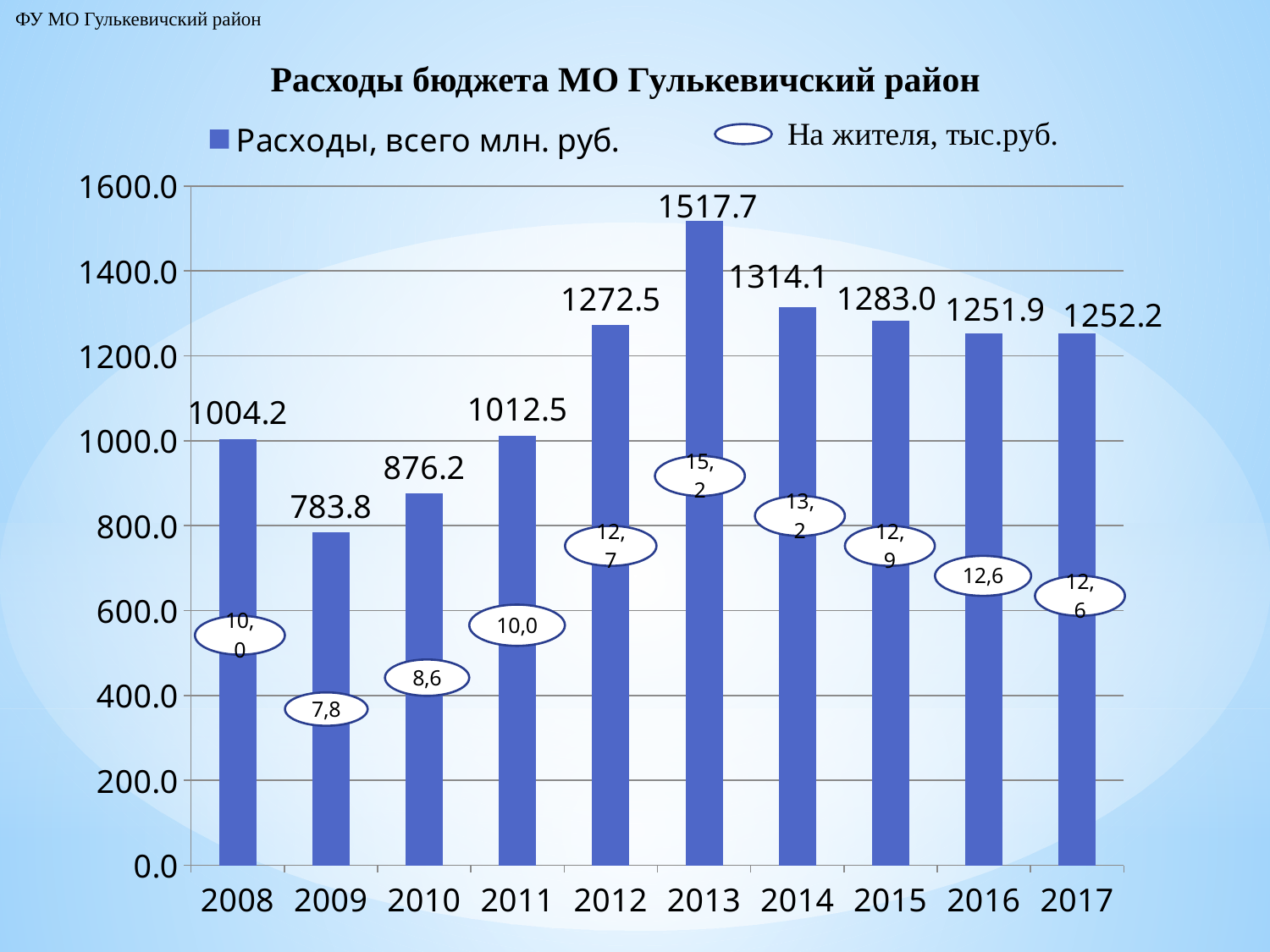
What is the title of the chart? Расходы бюджета МО Гулькевичский район Which year has the highest total budget expenditure? 2013 How many series does the legend list? 2 What type of chart is shown on the slide? bar chart Which year had higher total expenditure, 2011 or 2012? 2012 What was the total budget expenditure (Расходы, всего млн. руб.) in 2013? 1517.7 Is the total expenditure for 2010 greater or less than 1000.0? less How many years are shown on the x axis? 10 Which year has the lowest total budget expenditure? 2009 What was the total budget expenditure (Расходы, всего млн. руб.) in 2009? 783.8 What is the per-resident value (На жителя, тыс.руб.) shown for 2014? 13,2 What is the difference in total expenditure between 2013 and 2014? 203.6